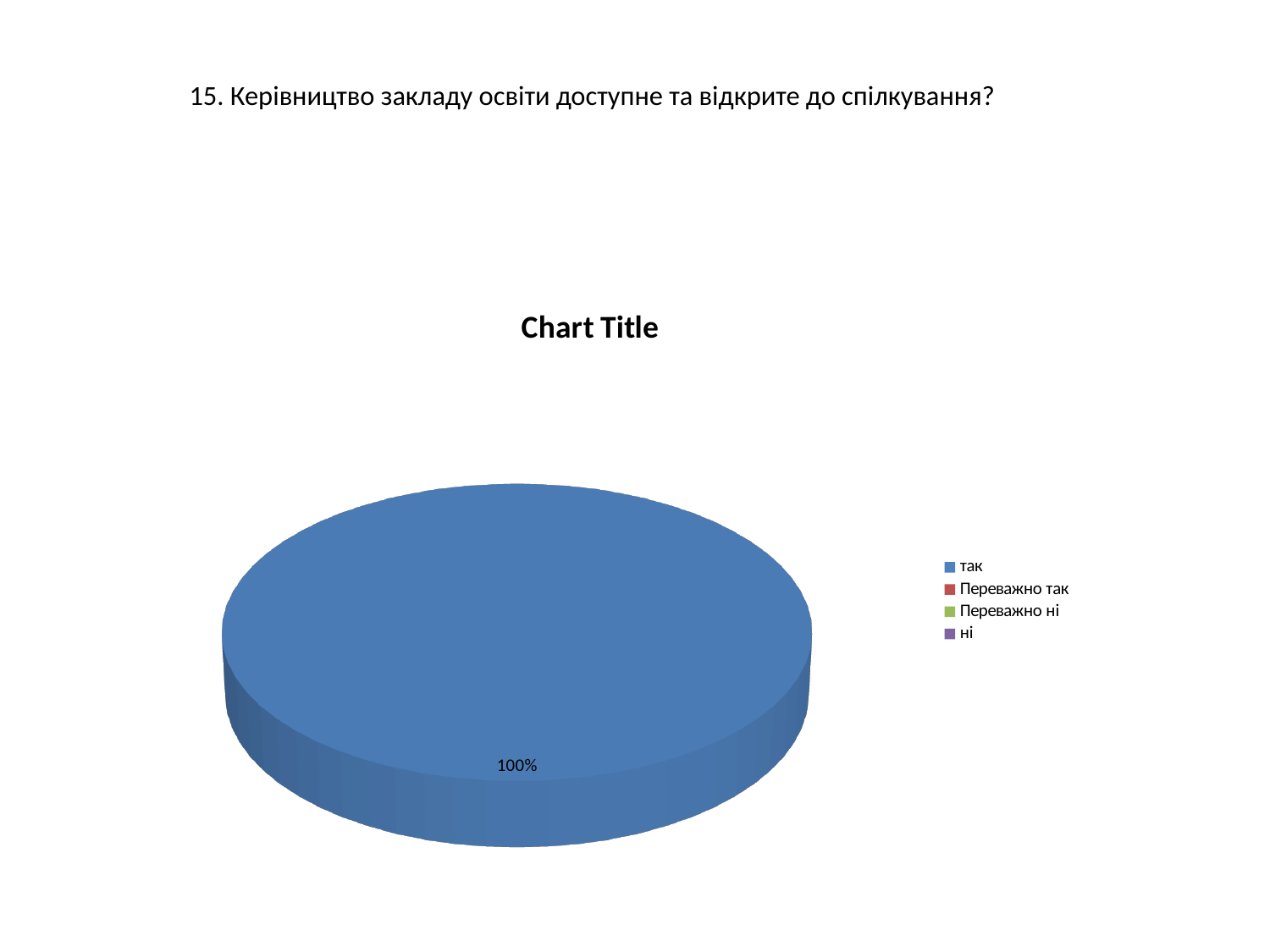
Which legend entry is listed last? ні What share of the pie does the "так" slice take? 100% Which category has the largest share of the pie? так What colour is the "так" slice of the pie? blue What kind of chart is shown on the slide? pie chart How many slices are visible in the pie? 1 What is the title shown above the pie chart? Chart Title How many entries does the legend list? 4 Is the share for "так" greater or less than 50%? greater